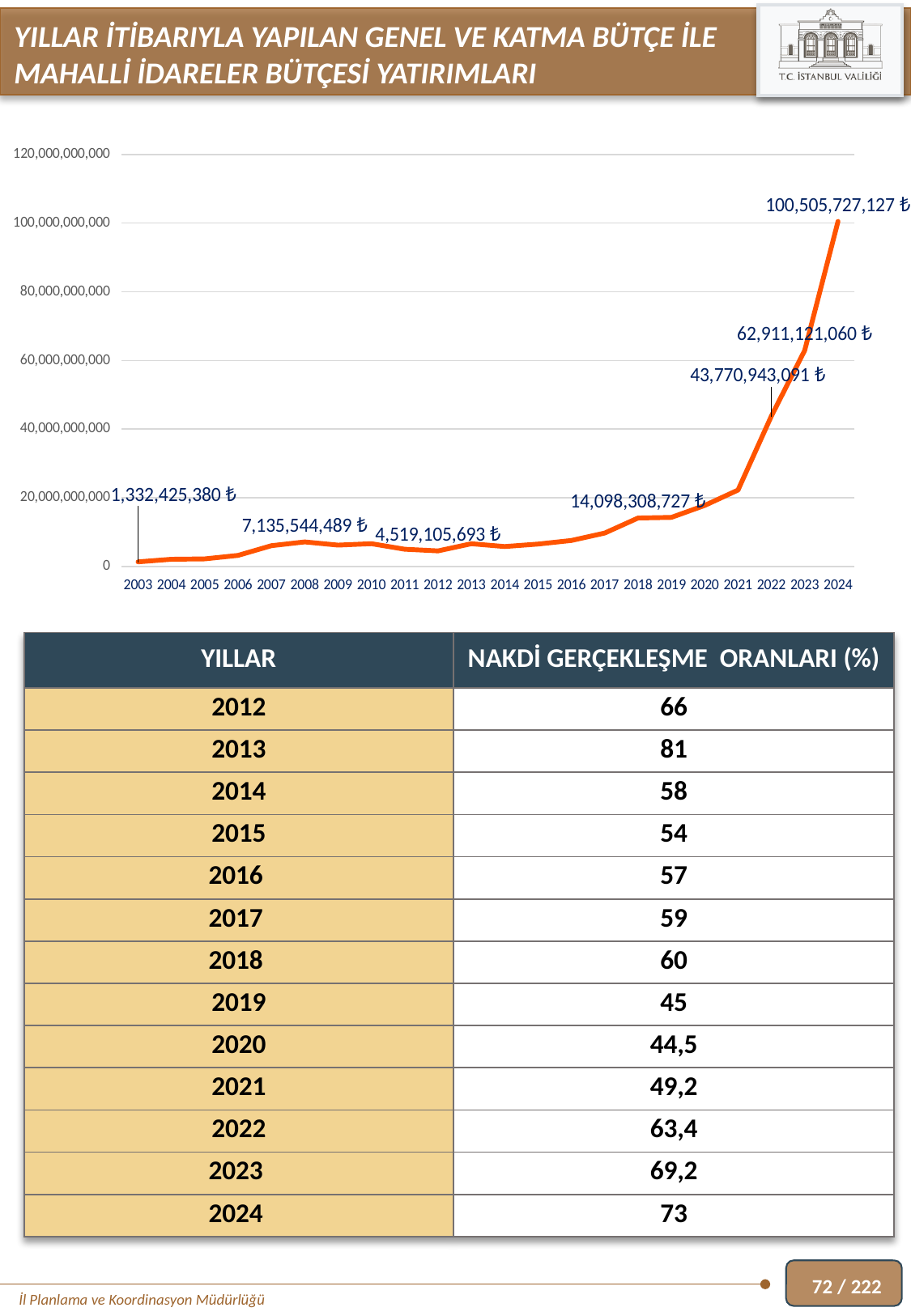
What is the difference between the labelled values for 2024 and 2023? 37,594,606,067 ₺ How many years are plotted along the x axis of the chart? 22 What is the value labelled for 2024 in the chart? 100,505,727,127 ₺ Which year has the lowest value in the chart? 2003 Which year has the highest value in the chart? 2024 What is the value labelled for 2003 in the chart? 1,332,425,380 ₺ What colour is the line in the chart? orange What is the value labelled for 2023 in the chart? 62,911,121,060 ₺ Is the value for 2021 greater or less than 40,000,000,000? less What is the difference between the labelled values for 2023 and 2022? 19,140,177,969 ₺ What kind of chart is shown on the slide? line chart Do the values generally rise or fall from 2003 to 2024? rise